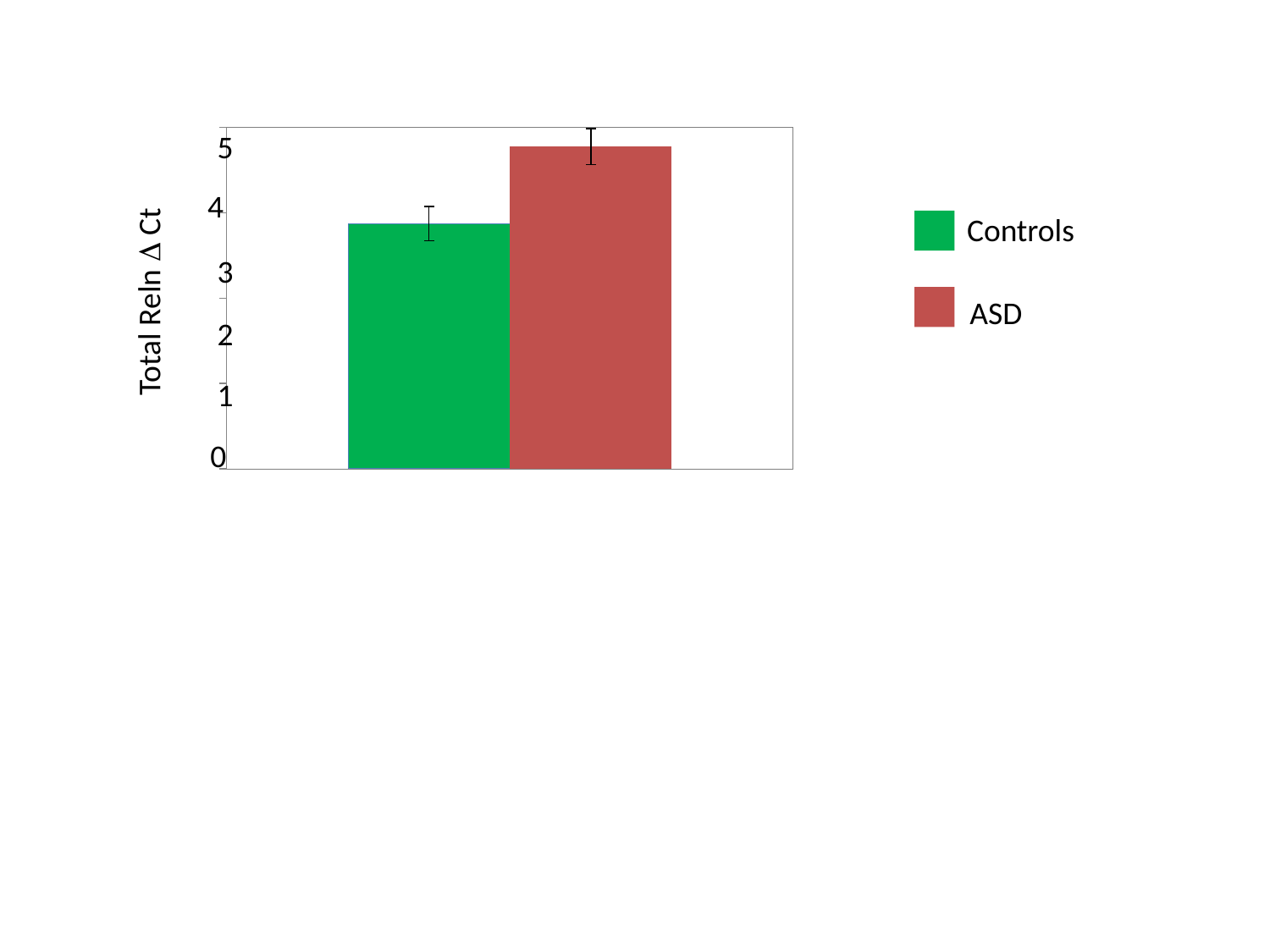
Is the value for Controls larger or smaller than the value for ASD? smaller Is the value for Controls greater or less than 4? less How many bars are plotted in the chart? 2 Which group has the lower Total Reln Δ Ct value? Controls What is the label on the vertical axis? Total Reln Δ Ct What colour is the bar for the ASD group? red Is the value for Controls greater or less than 3? greater Which group has the higher Total Reln Δ Ct value? ASD How many series does the legend list? 2 What kind of chart is shown on the slide? bar chart Is the value for ASD greater or less than 4? greater